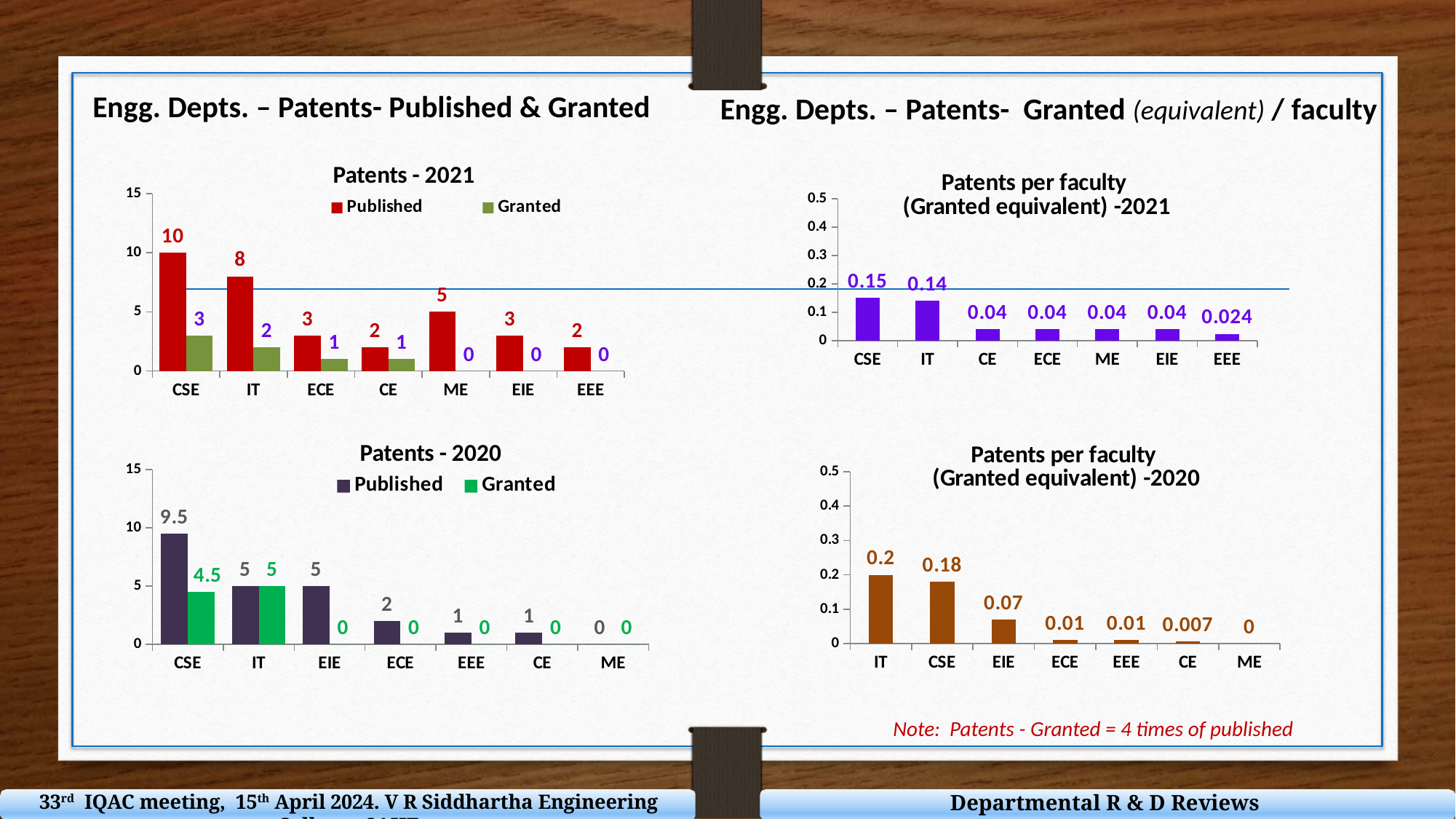
In the "Patents - 2021" chart, how many series does the legend list? 2 In the "Patents - 2020" chart, what is the Published value for CSE? 9.5 In the "Patents - 2020" chart, which is larger, the Granted value for CSE or the Granted value for IT? IT In the "Patents - 2020" chart, how many departments are shown on the x axis? 7 In the "Patents - 2021" chart, what is the difference between the Published values for CSE and IT? 2 In the "Patents per faculty (Granted equivalent) -2021" chart, what is the value for EEE? 0.024 In the "Patents per faculty (Granted equivalent) -2020" chart, what is the value for EIE? 0.07 In the "Patents - 2021" chart, which department has the highest Published value? CSE In the "Patents - 2021" chart, what is the Published value for CSE? 10 In the "Patents per faculty (Granted equivalent) -2021" chart, which department has the lowest value? EEE What kind of chart is the "Patents per faculty (Granted equivalent) -2020" chart? Bar chart In the "Patents - 2021" chart, what is the Granted value for IT? 2